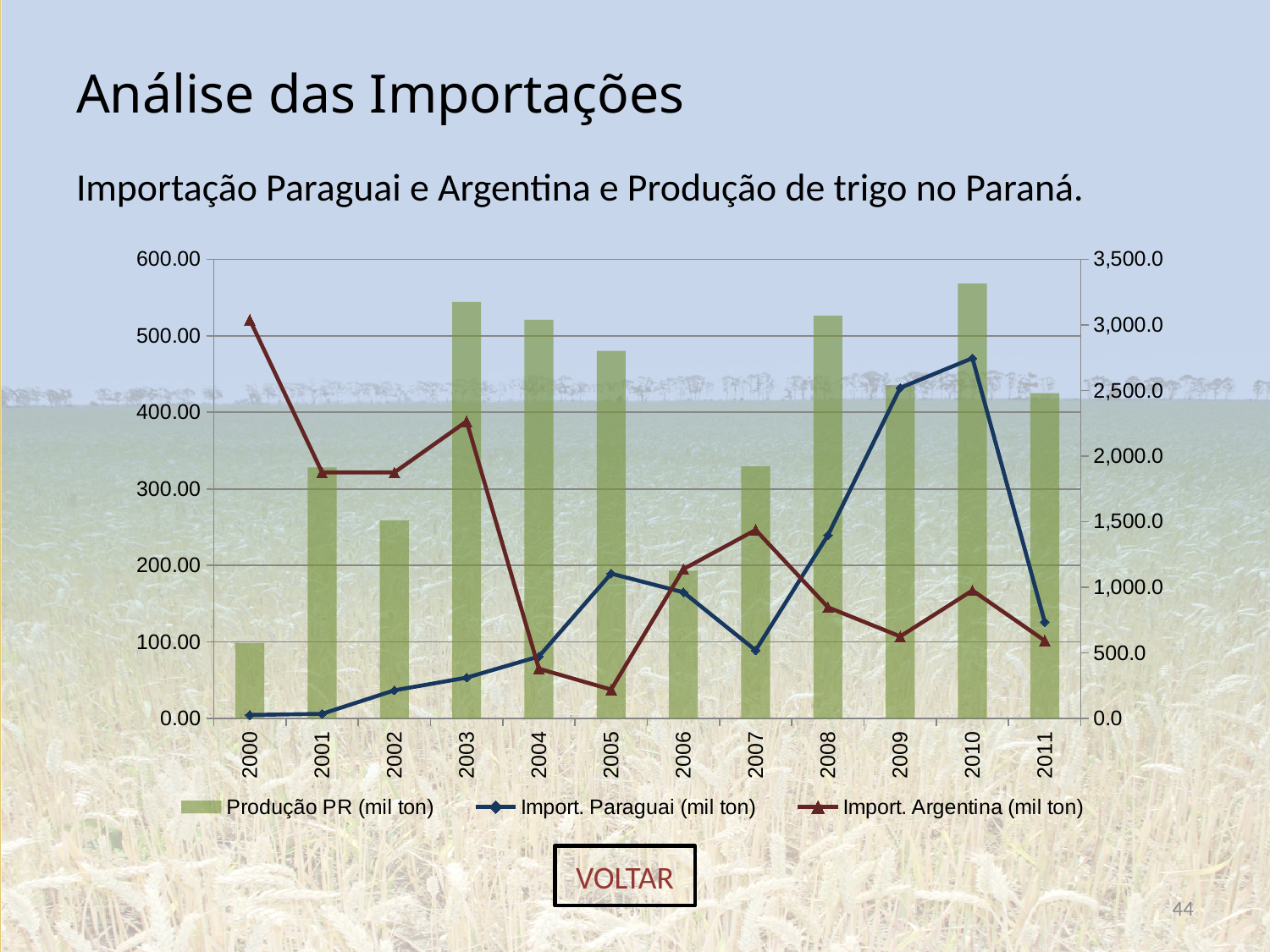
In 2000, which is larger: Import. Paraguai (mil ton) or Import. Argentina (mil ton)? Import. Argentina (mil ton) Is the value of Produção PR (mil ton) in 2003 greater or less than 3,000.0? greater Is the value of Produção PR (mil ton) in 2006 greater or less than 1,500.0? less What is the title of the chart on the slide? Importação Paraguai e Argentina e Produção de trigo no Paraná. How many series does the chart legend list? 3 In which year does Import. Paraguai (mil ton) reach its highest value? 2010 In which year is Produção PR (mil ton) lowest? 2000 What kind of chart is shown on the slide? A combination bar and line chart How many years are shown on the x axis of the chart? 12 In which year is Produção PR (mil ton) highest? 2010 In which year is Import. Argentina (mil ton) highest? 2000 In which year is Import. Argentina (mil ton) lowest? 2005